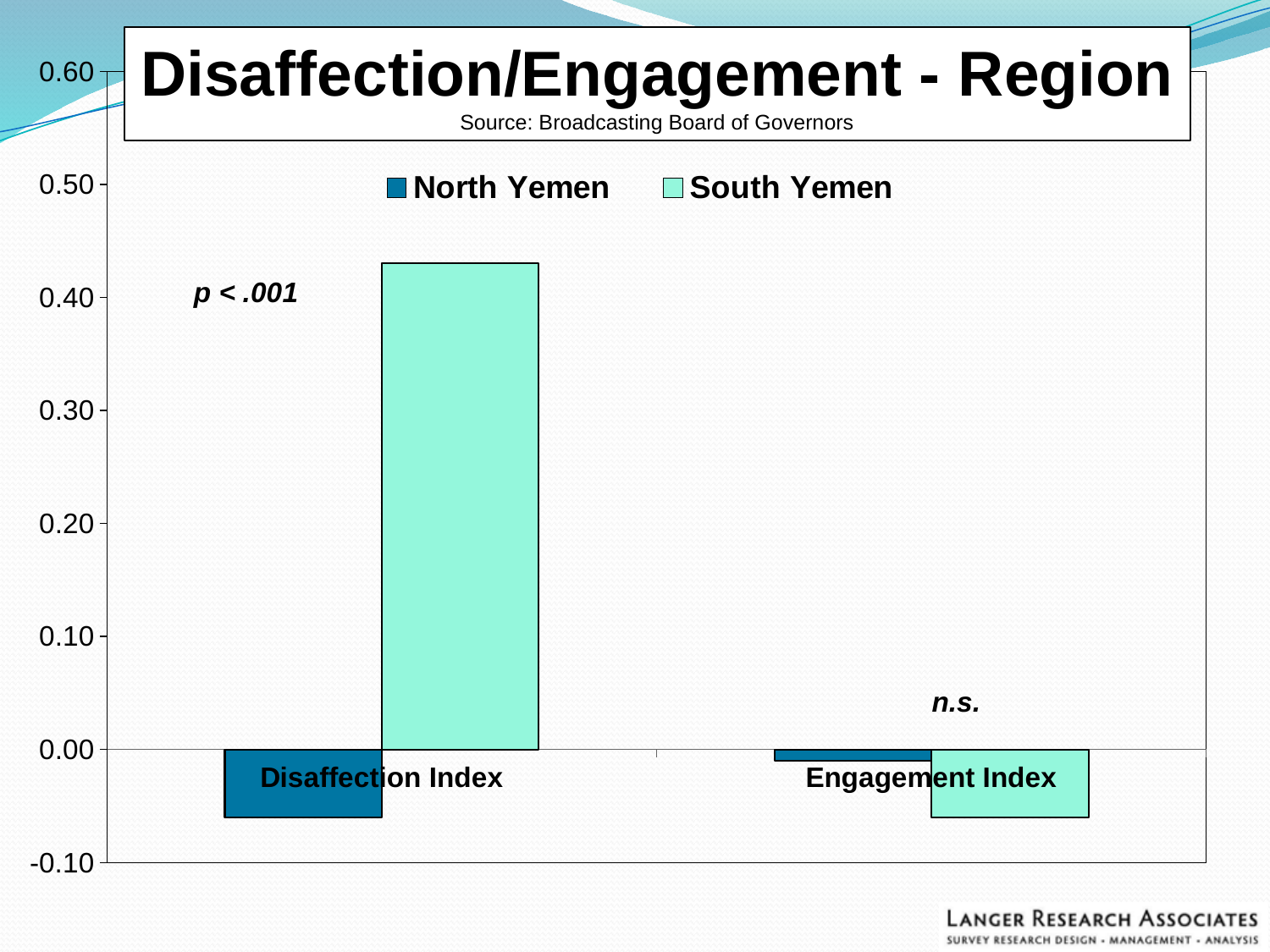
For the Disaffection Index, which region has the larger value, North Yemen or South Yemen? South Yemen How many categories are shown on the x axis? 2 Is the North Yemen value for the Disaffection Index greater or less than 0.00? less Is the South Yemen value for the Disaffection Index greater or less than 0.50? less What kind of chart is shown on the slide? bar chart What is the title of the chart? Disaffection/Engagement - Region Which bar is the highest on the chart? South Yemen, Disaffection Index Is the South Yemen value for the Disaffection Index greater or less than 0.40? greater For the Engagement Index, which region has the lower value, North Yemen or South Yemen? South Yemen How many series does the legend list? 2 What source is cited for the chart? Broadcasting Board of Governors